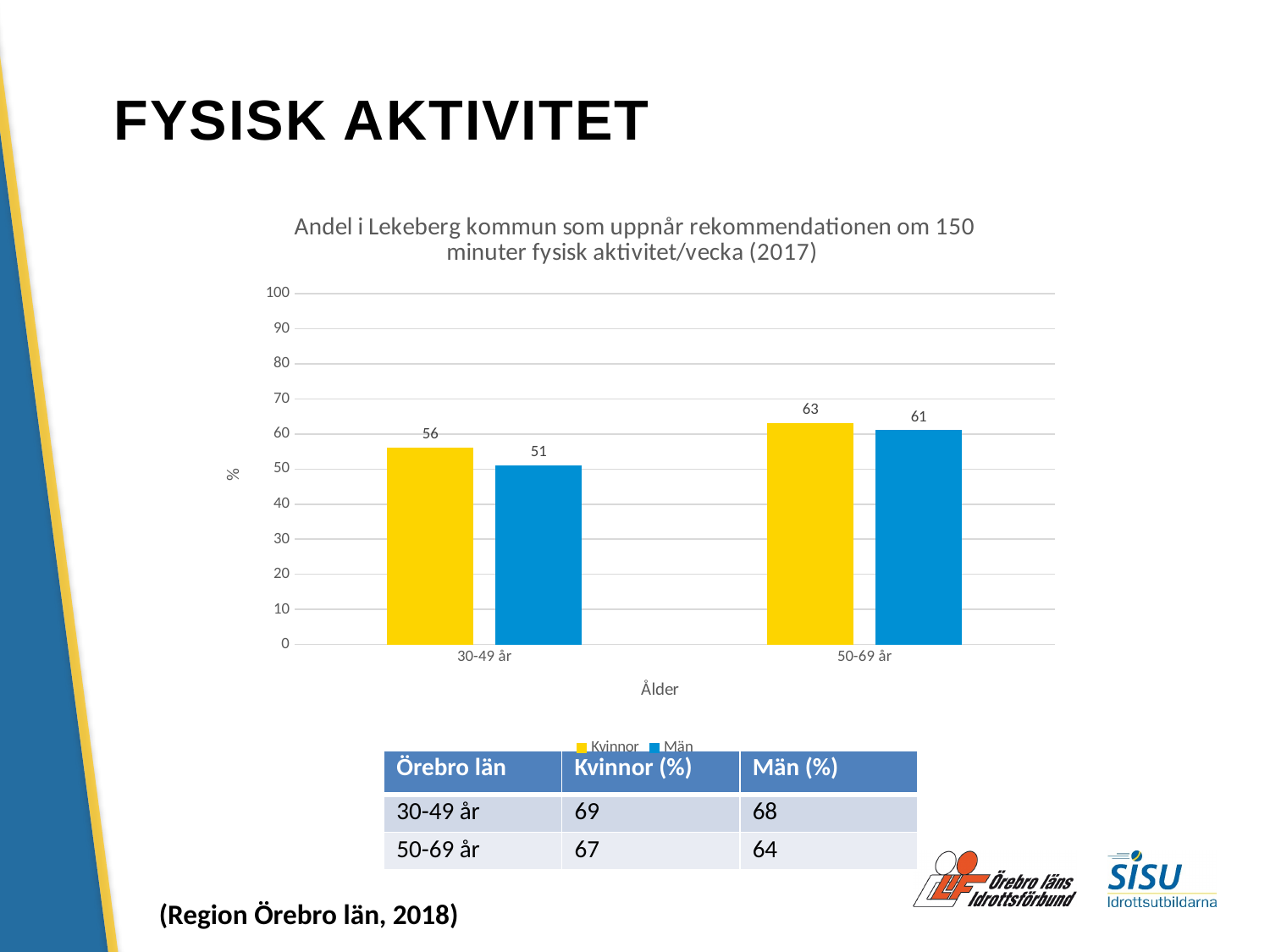
What kind of chart is shown on the slide? Bar chart What is the difference between the Kvinnor values for 50-69 år and 30-49 år? 7 What is the value for Män in the 30-49 år category? 51 How many series does the legend list? 2 What is the difference between Kvinnor and Män in the 30-49 år category? 5 Which colour represents Kvinnor in the chart? Yellow Which is larger in the 50-69 år category, Kvinnor or Män? Kvinnor Which age group has the highest value for Kvinnor? 50-69 år Which age group has the lowest value for Män? 30-49 år What is the value for Män in the 50-69 år category? 61 What is the value for Kvinnor in the 30-49 år category? 56 How many age categories are shown on the x axis? 2